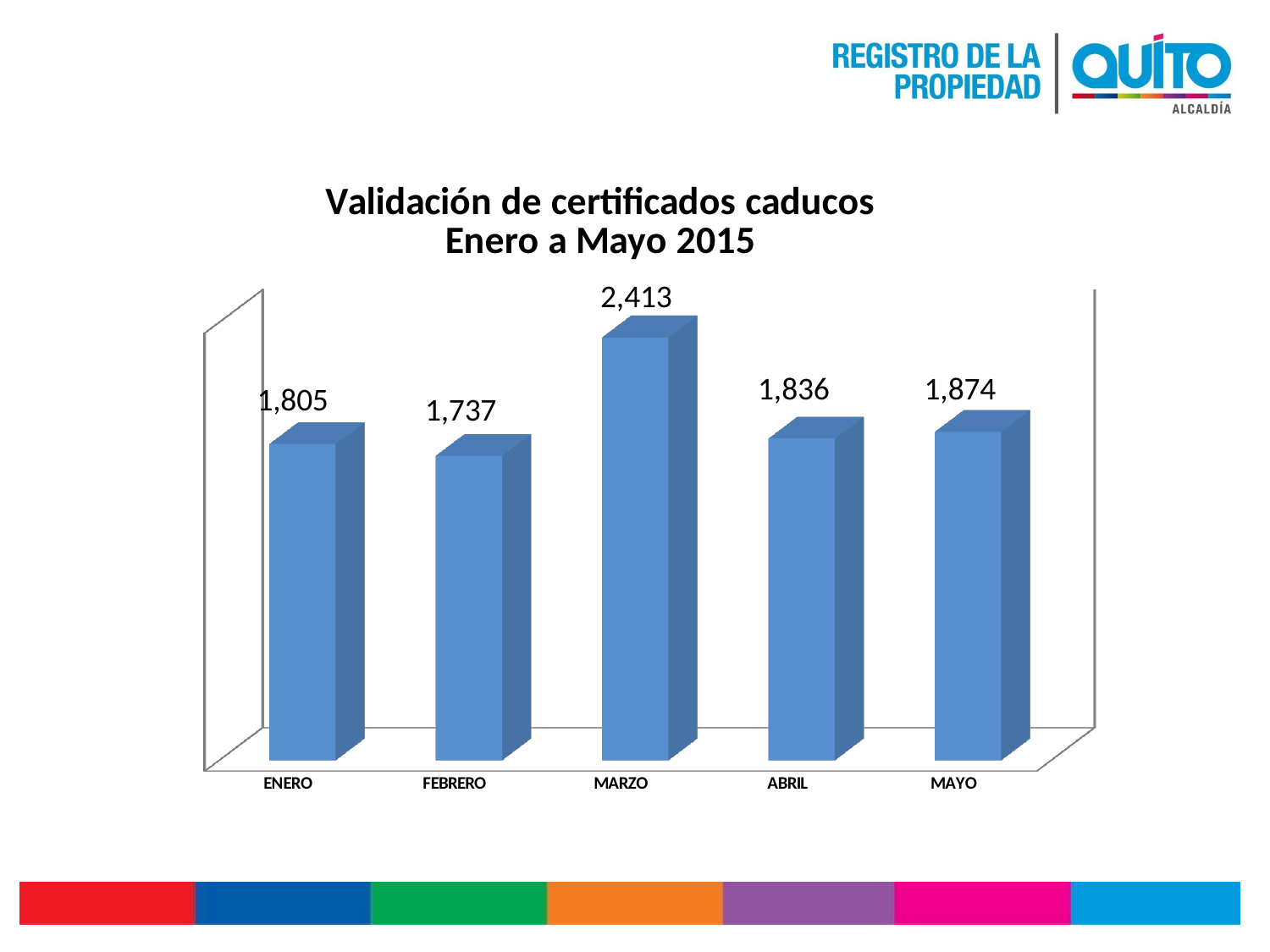
Which is larger, the value for ENERO or the value for ABRIL? ABRIL What is the title of the chart? Validación de certificados caducos Enero a Mayo 2015 What kind of chart is shown on the slide? Bar chart What is the difference between the values for MARZO and FEBRERO? 676 Which month has the lowest value? FEBRERO What is the value for ENERO? 1,805 What is the value for MARZO? 2,413 What is the value for FEBRERO? 1,737 What is the difference between the values for MAYO and ABRIL? 38 Which month has the highest value? MARZO How many months are shown on the chart? 5 What is the value for MAYO? 1,874